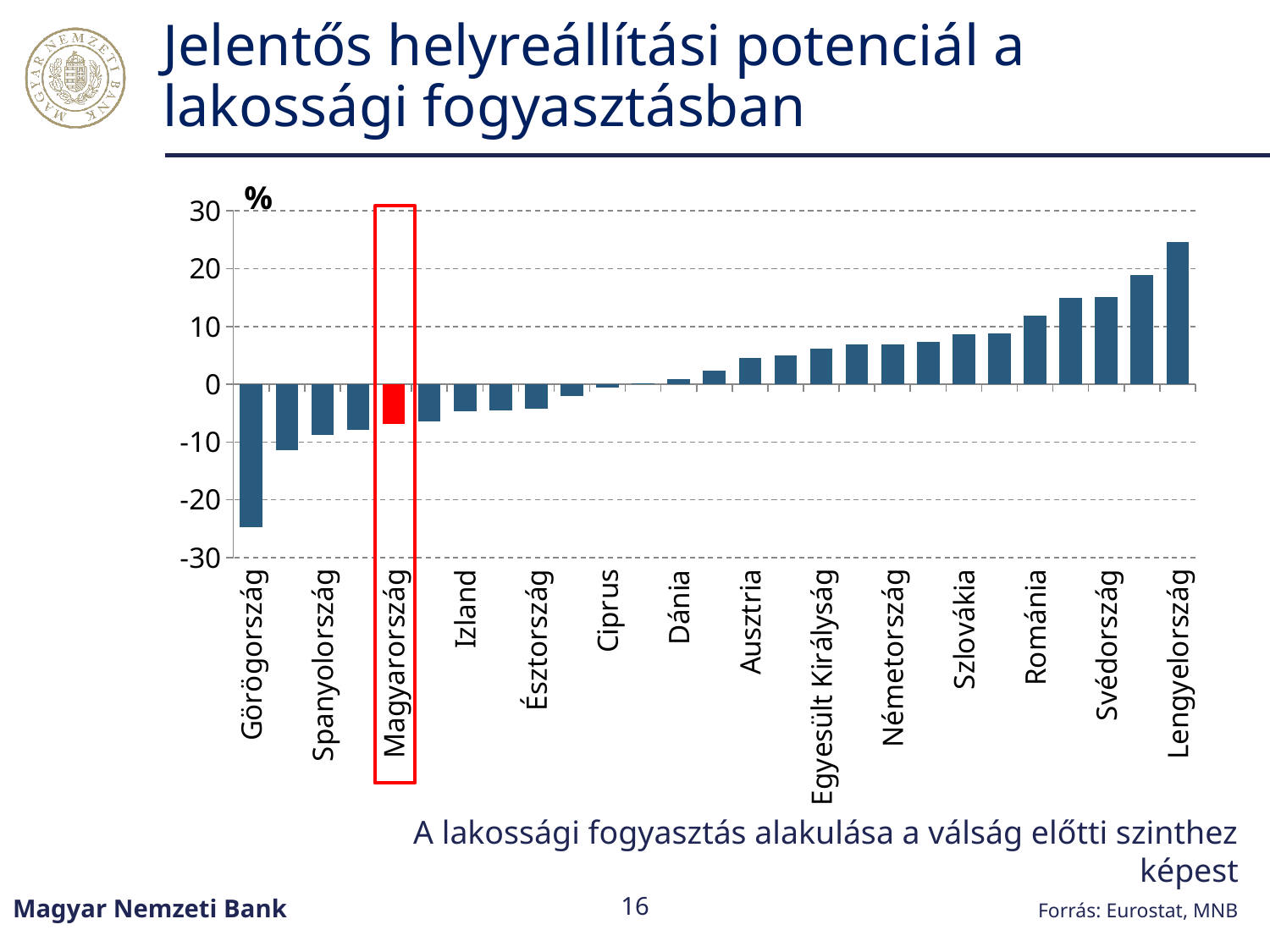
Which country's bar is highlighted in red and outlined with a red box? Magyarország Is the value for Lengyelország greater or less than 20? greater Is the value for Magyarország greater or less than -10? greater Which has the larger value, Lengyelország or Svédország? Lengyelország Which has the larger value, Spanyolország or Görögország? Spanyolország Is the value for Görögország greater or less than -20? less Which country has the lowest value in the chart? Görögország Do the values rise or fall moving from left to right along the x axis? rise What kind of chart is shown on the slide? bar chart Which country has the highest value in the chart? Lengyelország